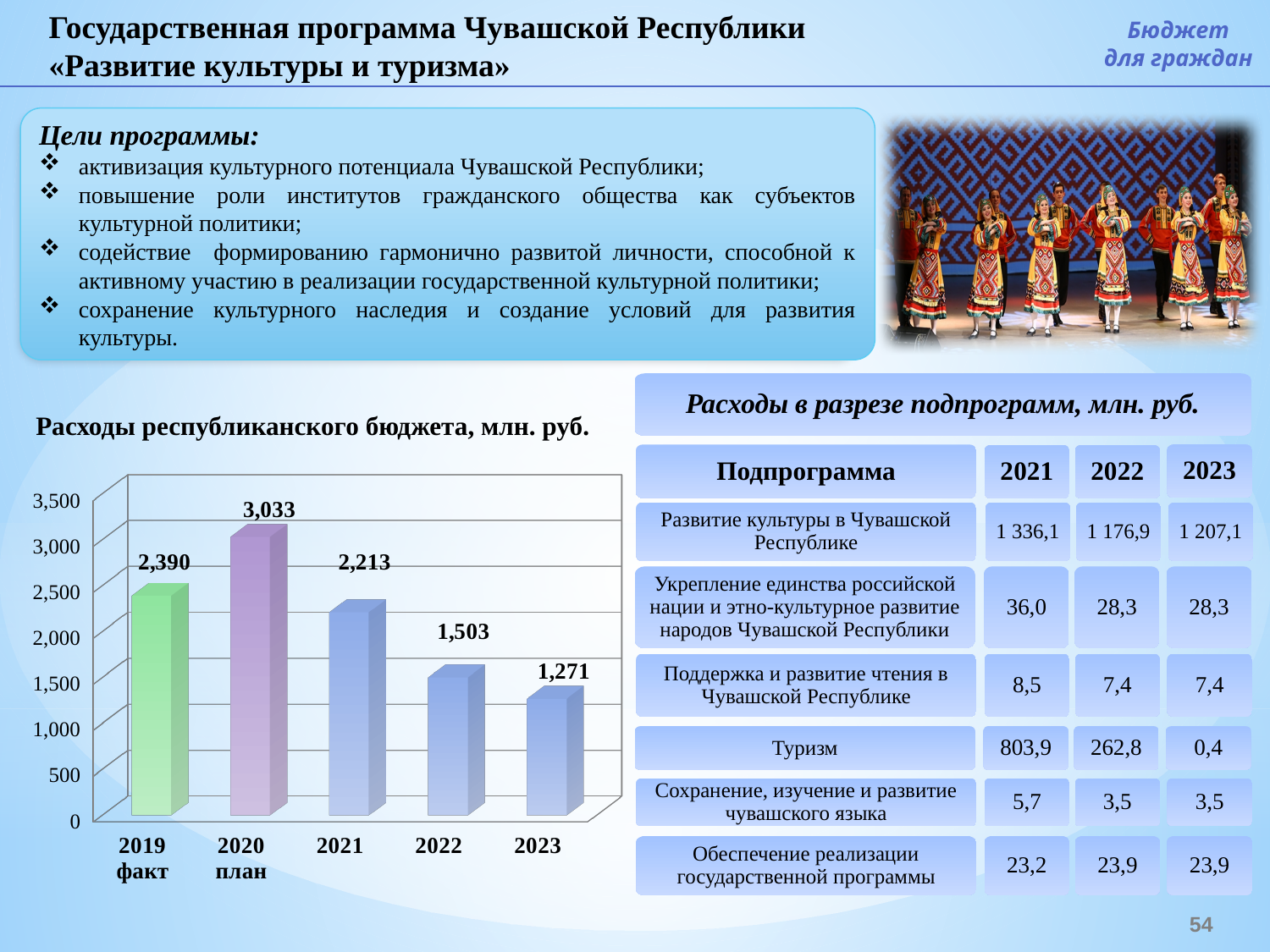
How many bars are shown in the chart 'Расходы республиканского бюджета, млн. руб.'? 5 What is the value for 2020 план in the chart 'Расходы республиканского бюджета, млн. руб.'? 3,033 What is the difference between the values for 2020 план and 2021 in the chart 'Расходы республиканского бюджета, млн. руб.'? 820 Which is larger in the chart 'Расходы республиканского бюджета, млн. руб.': the value for 2019 факт or the value for 2021? 2019 факт What is the difference between the values for 2022 and 2023 in the chart 'Расходы республиканского бюджета, млн. руб.'? 232 What is the value for 2019 факт in the chart 'Расходы республиканского бюджета, млн. руб.'? 2,390 In the chart 'Расходы республиканского бюджета, млн. руб.', do the values rise or fall from 2020 план to 2023? fall What is the value for 2023 in the chart 'Расходы республиканского бюджета, млн. руб.'? 1,271 Which year has the highest value in the chart 'Расходы республиканского бюджета, млн. руб.'? 2020 план Is the value for 2022 in the chart 'Расходы республиканского бюджета, млн. руб.' greater or less than 2,000? less Which year has the lowest value in the chart 'Расходы республиканского бюджета, млн. руб.'? 2023 What kind of chart is 'Расходы республиканского бюджета, млн. руб.'? bar chart